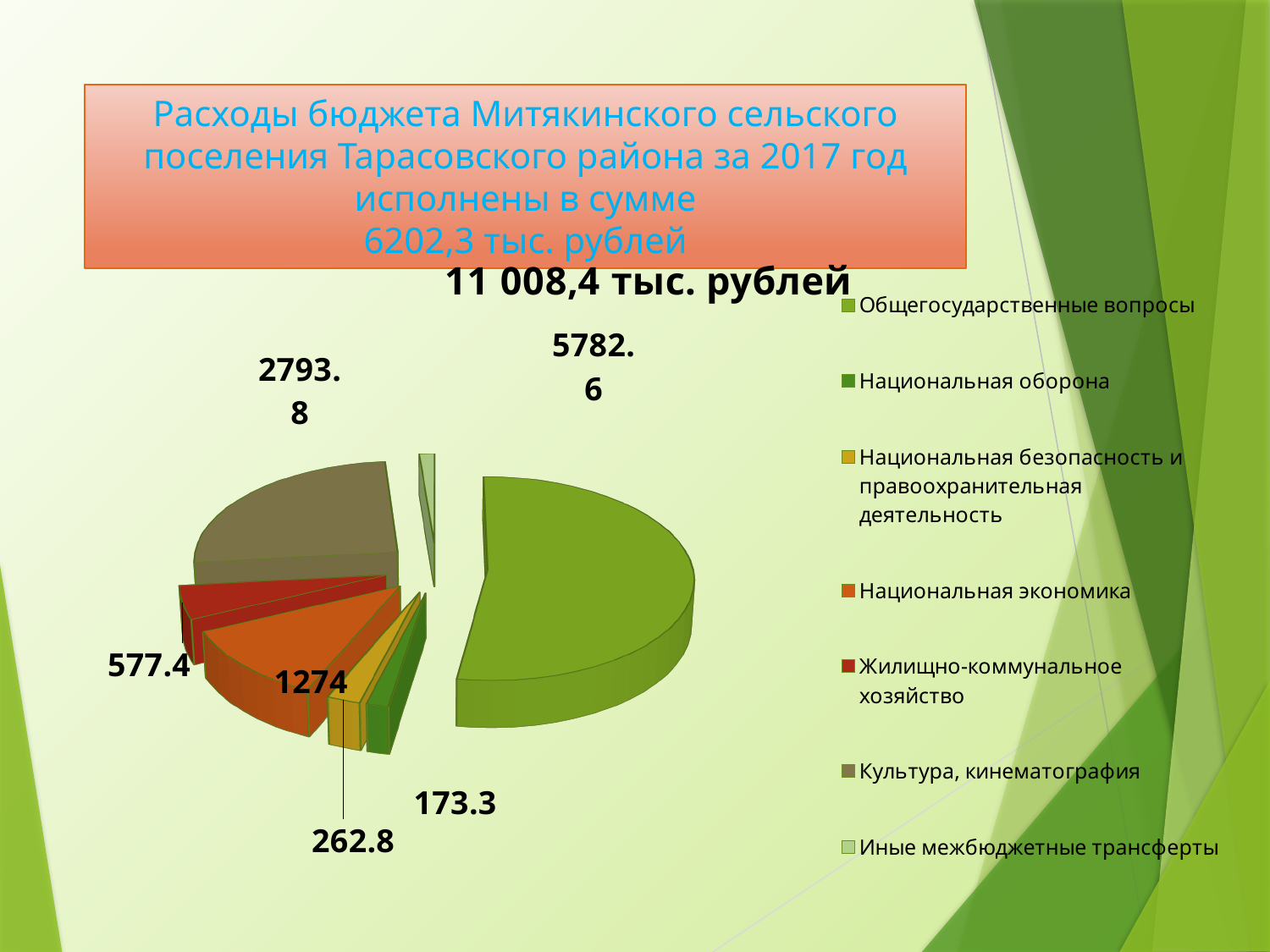
What is the difference between the values for Общегосударственные вопросы and Культура, кинематография? 2988.8 Which category has the largest slice of the pie? Общегосударственные вопросы What is the value shown for Национальная экономика? 1274 How many categories does the legend of the pie chart list? 7 Which is larger, the value for Национальная экономика or the value for Жилищно-коммунальное хозяйство? Национальная экономика What kind of chart is shown on the slide? pie chart What is the value shown for Жилищно-коммунальное хозяйство? 577.4 What is the title of the pie chart? 11 008,4 тыс. рублей What is the value shown for Национальная оборона? 173.3 What is the value shown for Культура, кинематография? 2793.8 What is the value shown for Национальная безопасность и правоохранительная деятельность? 262.8 What is the value shown for Общегосударственные вопросы? 5782.6